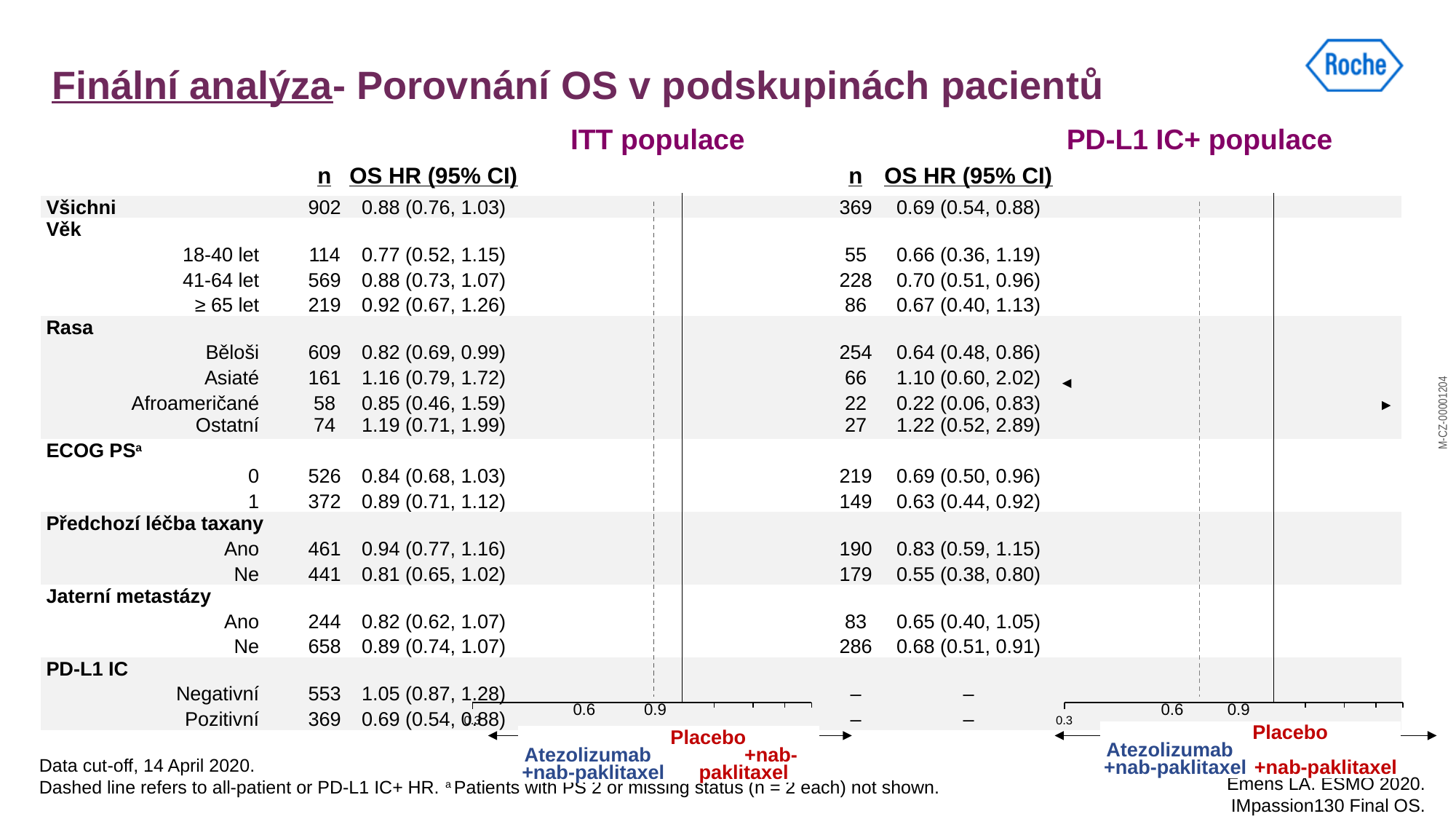
In the ITT populace panel, which has the larger OS HR point estimate for Předchozí léčba taxany: Ano or Ne? Ano In the ITT populace panel, what is the OS HR (95% CI) for Všichni? 0.88 (0.76, 1.03) What kind of chart is shown on the slide? Forest plot In the PD-L1 IC+ populace panel, what is the OS HR (95% CI) for Afroameričané? 0.22 (0.06, 0.83) In the ITT populace panel, what is n for the Asiaté subgroup? 161 According to the footnote, what does the dashed line refer to? All-patient or PD-L1 IC+ HR How many age (Věk) subgroups are listed? 3 In the ITT populace panel, which subgroup has the highest OS HR point estimate? Ostatní In the PD-L1 IC+ populace panel, which subgroup has the lowest OS HR point estimate? Afroameričané In the PD-L1 IC+ populace panel, what is n for ECOG PS 1? 149 In the PD-L1 IC+ populace panel, what is the OS HR (95% CI) for Všichni? 0.69 (0.54, 0.88) In the ITT populace panel, what is the difference in n between PD-L1 IC Negativní and Pozitivní? 184